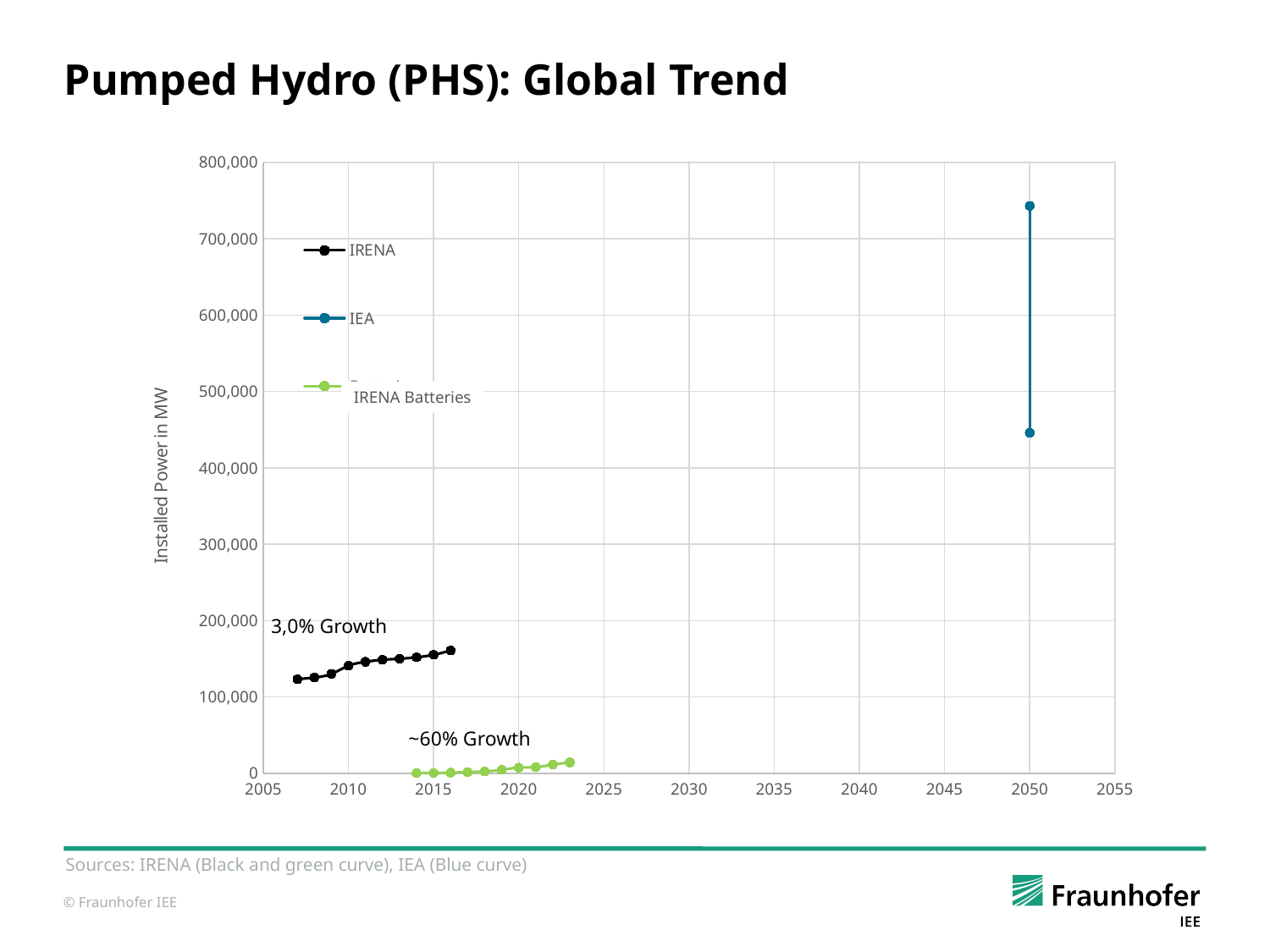
How many series does the legend list? 3 Which series are listed in the legend? IRENA, IEA, IRENA Batteries Is the IRENA value for 2007 greater or less than 100,000? greater Which is larger: the IRENA value in 2016 or the IRENA Batteries value in 2023? IRENA value in 2016 Is the upper IEA point at 2050 greater or less than 700,000? greater What is the label of the y axis? Installed Power in MW Is the IRENA value for 2016 greater or less than 200,000? less What kind of chart is shown on the slide? Line chart Does the IRENA Batteries series rise or fall from 2014 to 2023? Rise How many data points are plotted for the IEA series? 2 Does the IRENA series rise or fall from 2007 to 2016? Rise